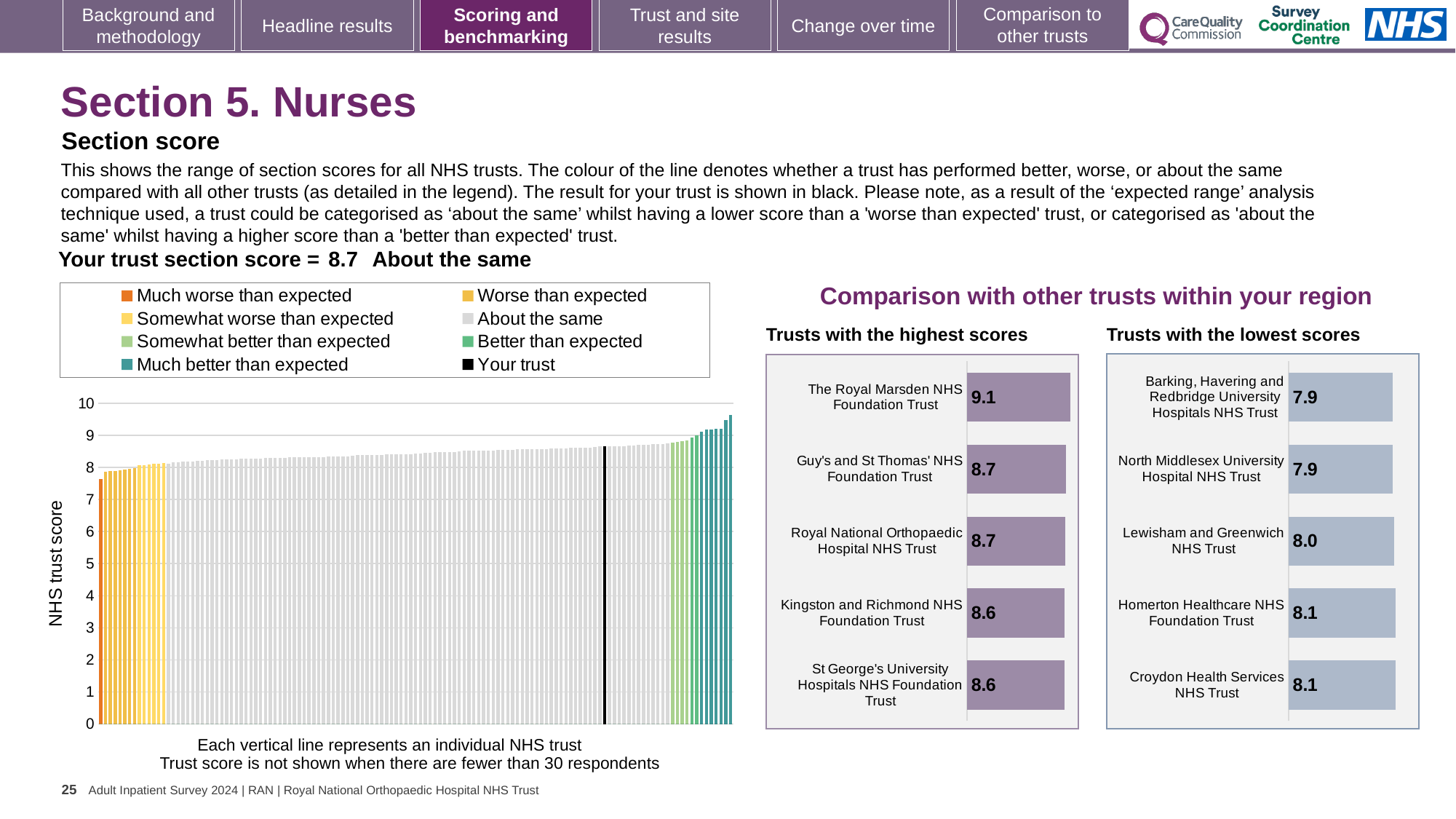
In the 'Trusts with the highest scores' chart, what is the score for The Royal Marsden NHS Foundation Trust? 9.1 How many trusts are shown in the 'Trusts with the highest scores' chart? 5 In the large chart on the left showing NHS trust scores, do the bar values rise or fall from left to right? Rise In the 'Trusts with the highest scores' chart, which trust has the highest score? The Royal Marsden NHS Foundation Trust In the 'Trusts with the highest scores' chart, what is the difference between the scores of The Royal Marsden NHS Foundation Trust and Kingston and Richmond NHS Foundation Trust? 0.5 In the 'Trusts with the lowest scores' chart, which trust has a higher score: Croydon Health Services NHS Trust or Barking, Havering and Redbridge University Hospitals NHS Trust? Croydon Health Services NHS Trust In the large chart on the left showing NHS trust scores, how many entries does the legend list? 8 In the large chart on the left showing NHS trust scores, is the value of the leftmost (lowest) bar greater or less than 8? less In the 'Trusts with the lowest scores' chart, what is the score for Lewisham and Greenwich NHS Trust? 8.0 In the 'Trusts with the lowest scores' chart, what is the difference between the scores of Homerton Healthcare NHS Foundation Trust and North Middlesex University Hospital NHS Trust? 0.2 In the large chart on the left showing NHS trust scores, what colour represents 'Your trust'? Black What kind of chart is the 'Trusts with the lowest scores' chart? Bar chart